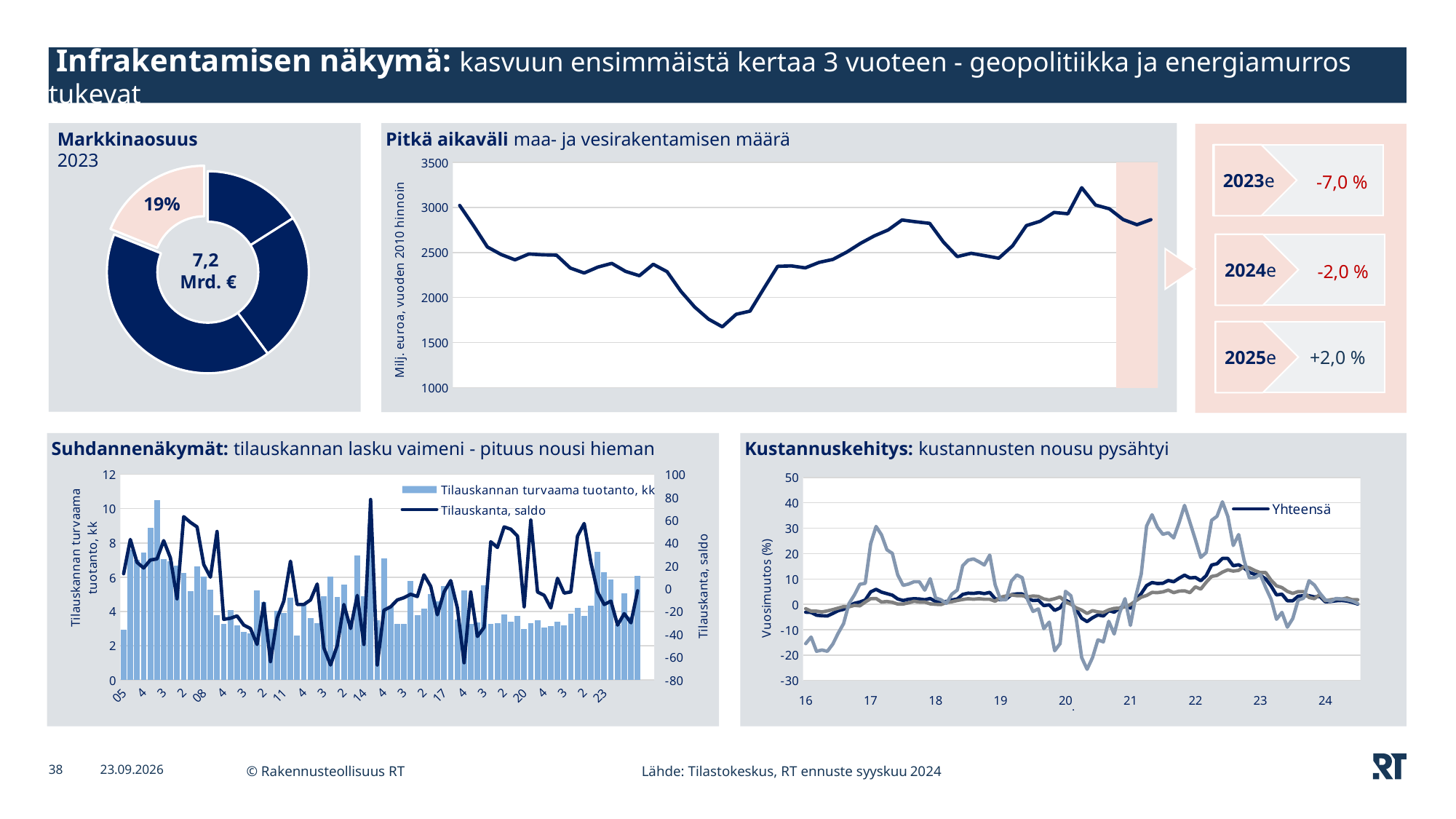
On the Kustannuskehitys chart, is the highest peak of the light blue line greater or less than 30? greater How many series does the legend of the Kustannuskehitys chart list? 1 On the Markkinaosuus 2023 chart, what value is printed in the centre of the donut? 7,2 Mrd. € What is the y-axis label of the 'Pitkä aikaväli' chart? Milj. euroa, vuoden 2010 hinnoin How many series does the legend of the Suhdannenäkymät chart list? 2 On the Suhdannenäkymät chart, which series is drawn as bars? Tilauskannan turvaama tuotanto, kk On the 'Pitkä aikaväli' chart, is the lowest point of the line greater or less than 2000? less How many slices does the Markkinaosuus 2023 donut chart have? 4 What kind of chart is the Markkinaosuus 2023 chart? Donut (pie) chart On the Markkinaosuus 2023 chart, what share does the highlighted (light pink) slice represent? 19% What kind of chart is the 'Pitkä aikaväli maa- ja vesirakentamisen määrä' chart? Line chart On the 'Pitkä aikaväli' chart, is the highest point of the line greater or less than 3000? greater